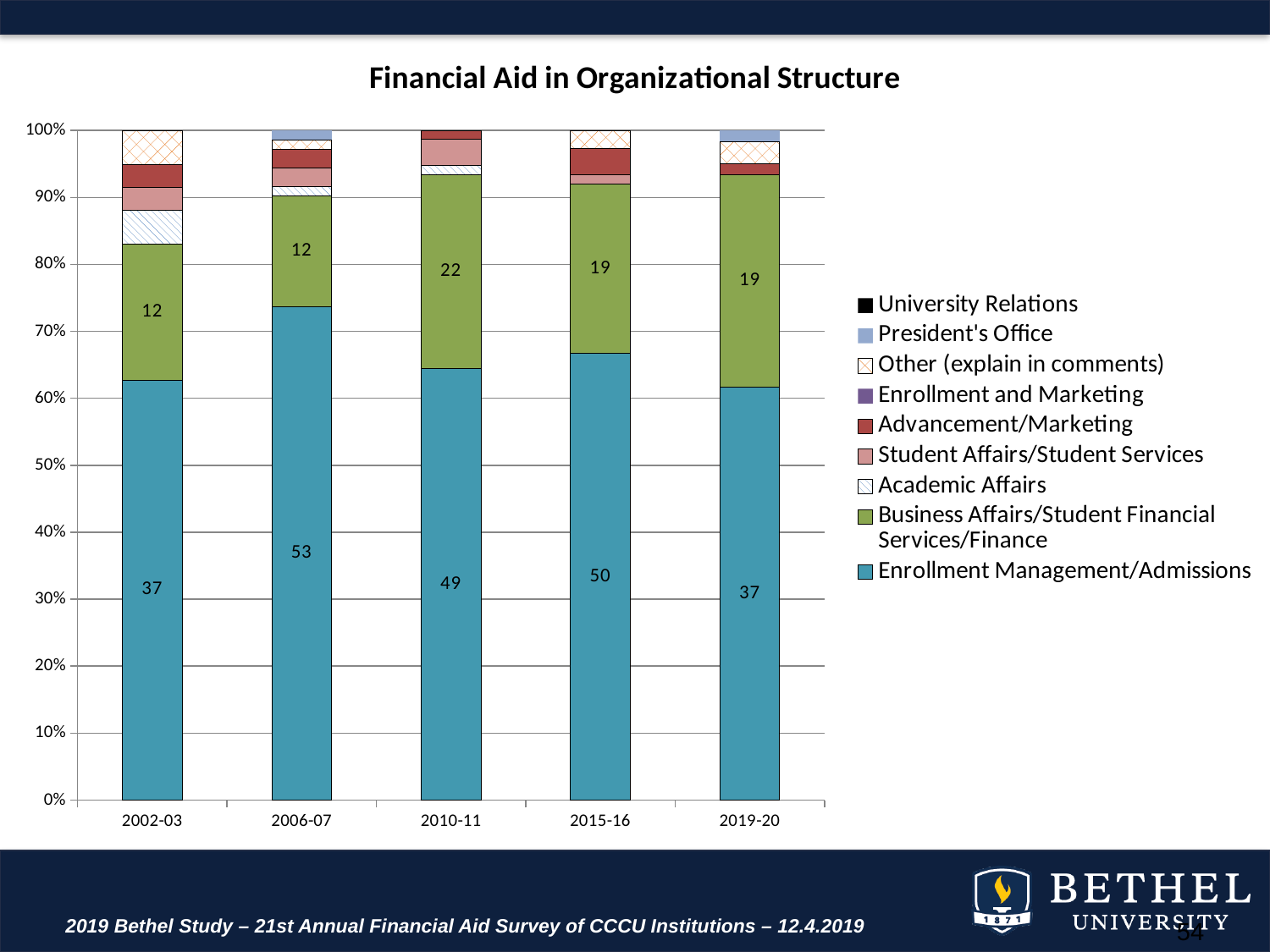
What is the data label for Enrollment Management/Admissions in 2006-07? 53 What is the data label for Enrollment Management/Admissions in 2019-20? 37 In which year does the Business Affairs/Student Financial Services/Finance series have its highest labeled value? 2010-11 In which year does the Enrollment Management/Admissions series have its highest labeled value? 2006-07 What kind of chart is shown on the slide? Stacked bar chart Is the top of the Enrollment Management/Admissions segment for 2006-07 greater or less than 70%? greater Which is larger, the Business Affairs/Student Financial Services/Finance label for 2010-11 or for 2015-16? 2010-11 What is the difference between the Enrollment Management/Admissions labels for 2006-07 and 2002-03? 16 What is the difference between the Business Affairs/Student Financial Services/Finance labels for 2010-11 and 2006-07? 10 How many years are shown on the x axis? 5 What is the data label for Business Affairs/Student Financial Services/Finance in 2010-11? 22 How many series does the legend list? 9